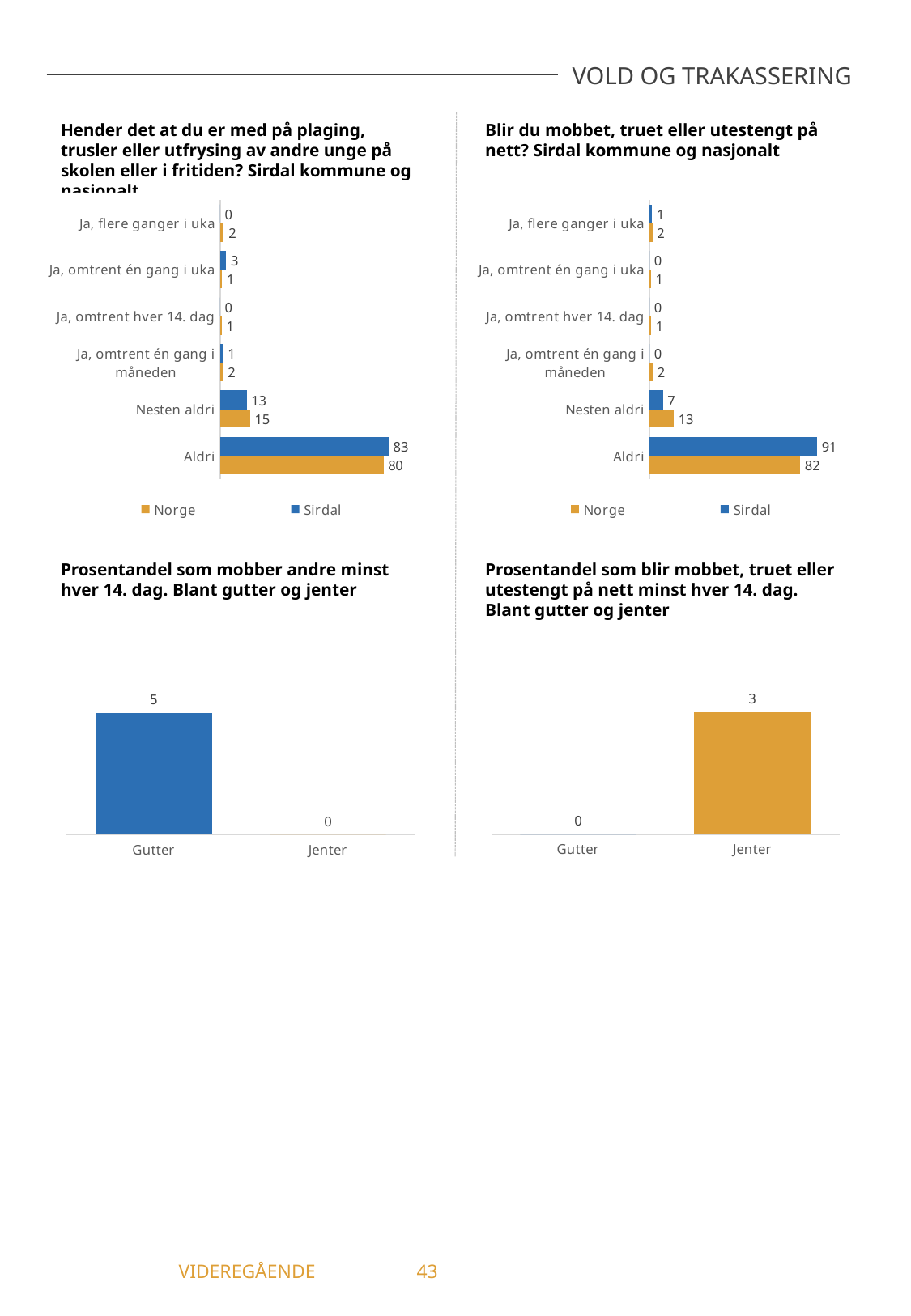
In the bottom-left chart ("Prosentandel som mobber andre minst hver 14. dag"), which category has the lowest value? Jenter In the top-right chart ("Blir du mobbet, truet eller utestengt på nett?"), which is larger for "Nesten aldri": Norge or Sirdal? Norge In the top-right chart ("Blir du mobbet, truet eller utestengt på nett?"), what is the value for Sirdal in the "Aldri" category? 91 In the top-right chart ("Blir du mobbet, truet eller utestengt på nett?"), how many categories are shown? 6 In the top-left chart ("Hender det at du er med på plaging..."), what is the value for Sirdal in the "Aldri" category? 83 In the top-left chart ("Hender det at du er med på plaging..."), how many series does the legend list? 2 In the top-left chart ("Hender det at du er med på plaging..."), what is the value for Norge in the "Nesten aldri" category? 15 In the top-left chart ("Hender det at du er med på plaging..."), what is the difference between the Sirdal and Norge values for "Aldri"? 3 In the bottom-right chart ("Prosentandel som blir mobbet, truet eller utestengt på nett minst hver 14. dag"), what is the value for Jenter? 3 In the bottom-left chart ("Prosentandel som mobber andre minst hver 14. dag"), what is the value for Gutter? 5 In the top-right chart ("Blir du mobbet, truet eller utestengt på nett?"), what is the value for Norge in the "Nesten aldri" category? 13 What kind of chart is the bottom-right chart ("Prosentandel som blir mobbet, truet eller utestengt på nett minst hver 14. dag")? Bar chart